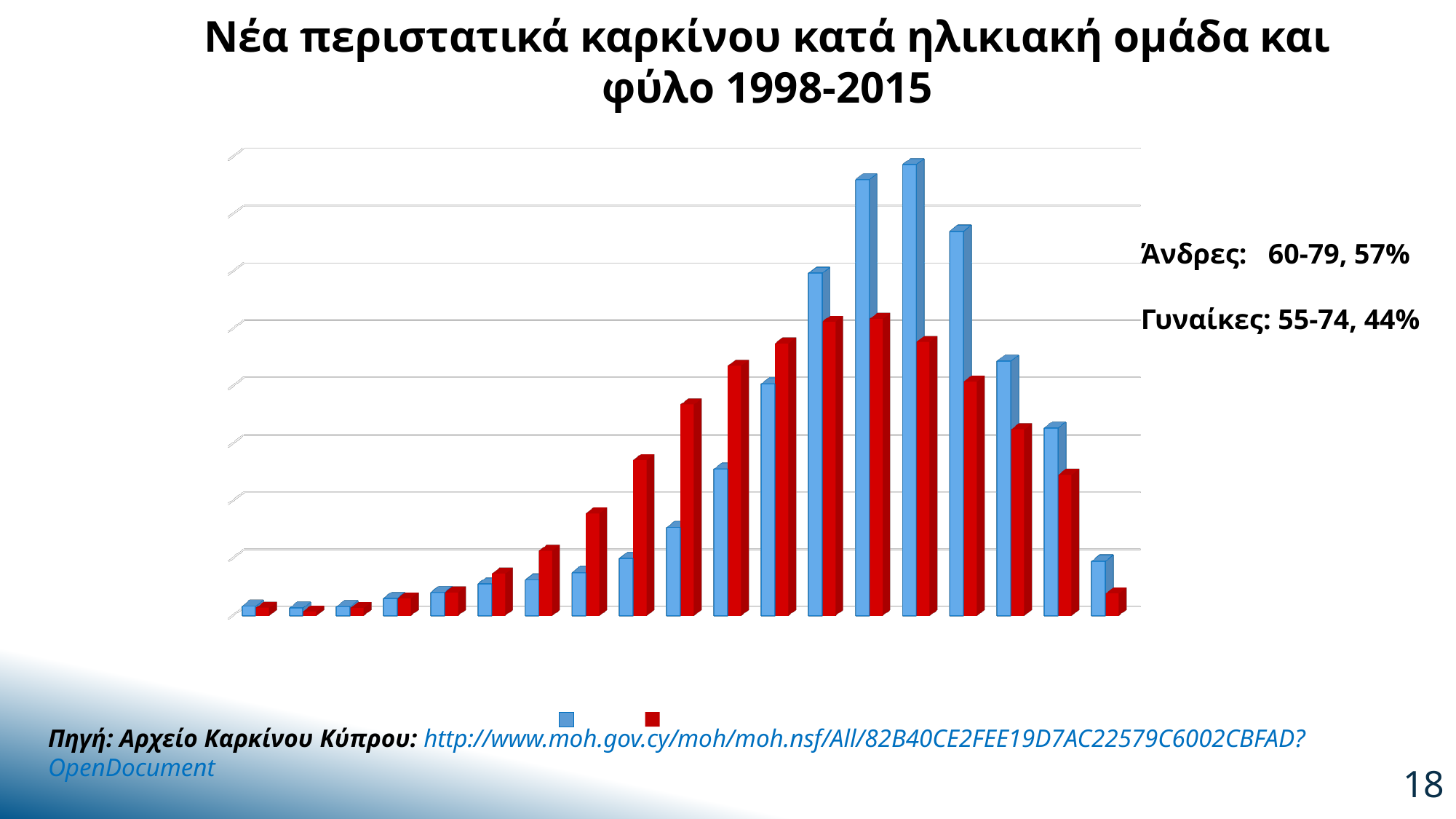
How many groups of bars are plotted along the x axis? 19 Is the tallest bar in the chart blue or red? blue How many series does the chart's legend show? 2 Do the blue bars rise steadily from left to right, or do they rise and then fall? rise and then fall What is the title of the chart? Νέα περιστατικά καρκίνου κατά ηλικιακή ομάδα και φύλο 1998-2015 Do the red bars rise steadily from left to right, or do they rise and then fall? rise and then fall What two colours are used for the bars in the chart? blue and red What kind of chart is shown on the slide? bar chart In the rightmost group of bars, is the blue bar taller or shorter than the red bar? taller In the group where the red bar reaches its highest value, is the blue bar taller or shorter than the red bar? taller